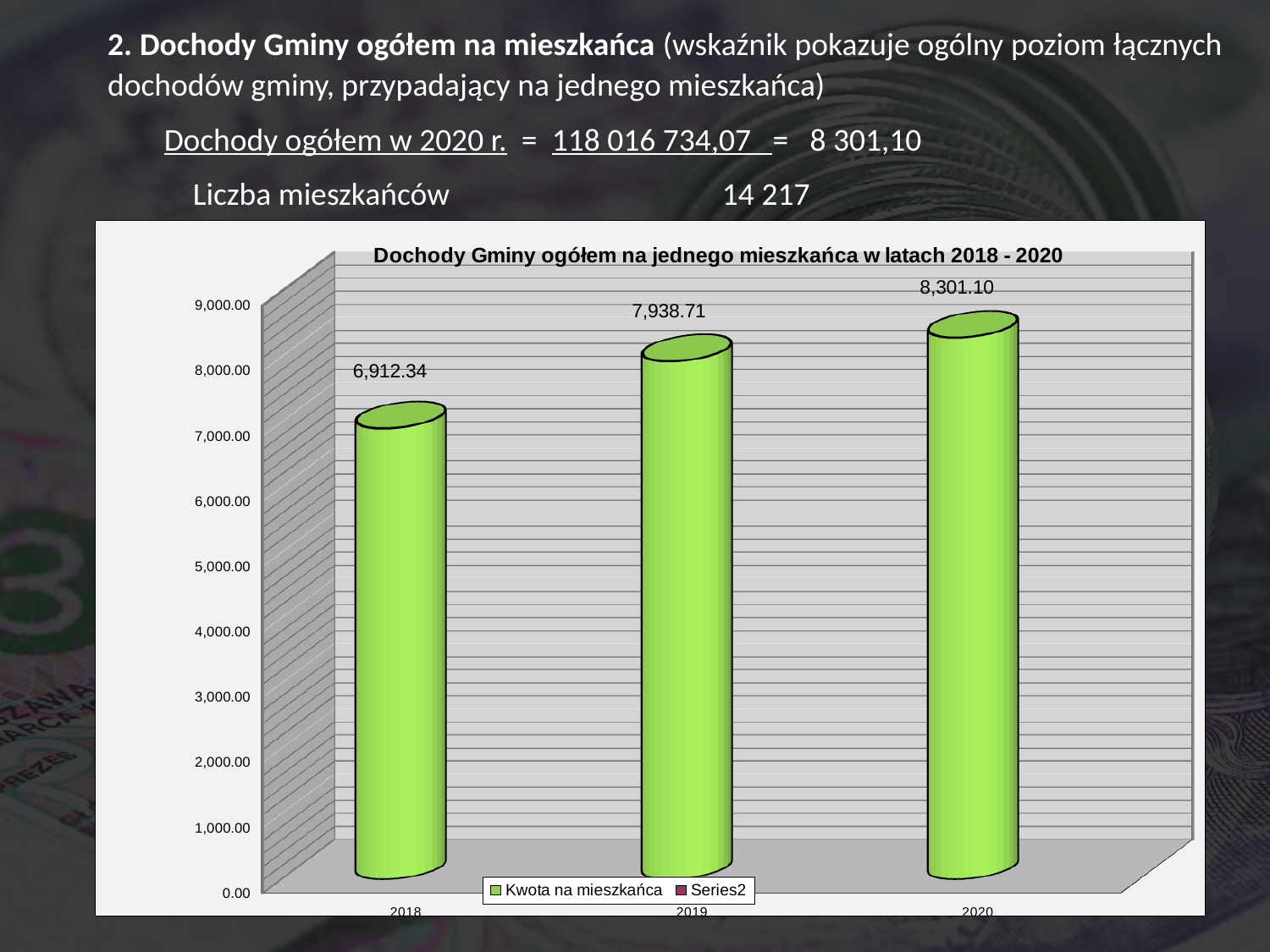
Which year has the lowest value in the chart? 2018 What is the difference between the values for 2020 and 2019? 362.39 How many years are shown in the chart? 3 What is the value for 2020 in the chart? 8,301.10 What kind of chart is shown on the slide? bar chart What is the difference between the values for 2019 and 2018? 1,026.37 What is the value for 2018 in the chart? 6,912.34 Which is larger, the value for 2018 or the value for 2020? 2020 What is the value for 2019 in the chart? 7,938.71 Is the value for 2018 greater or less than 7,000.00? less Which year has the highest value in the chart? 2020 Do the values rise or fall from 2018 to 2020? rise